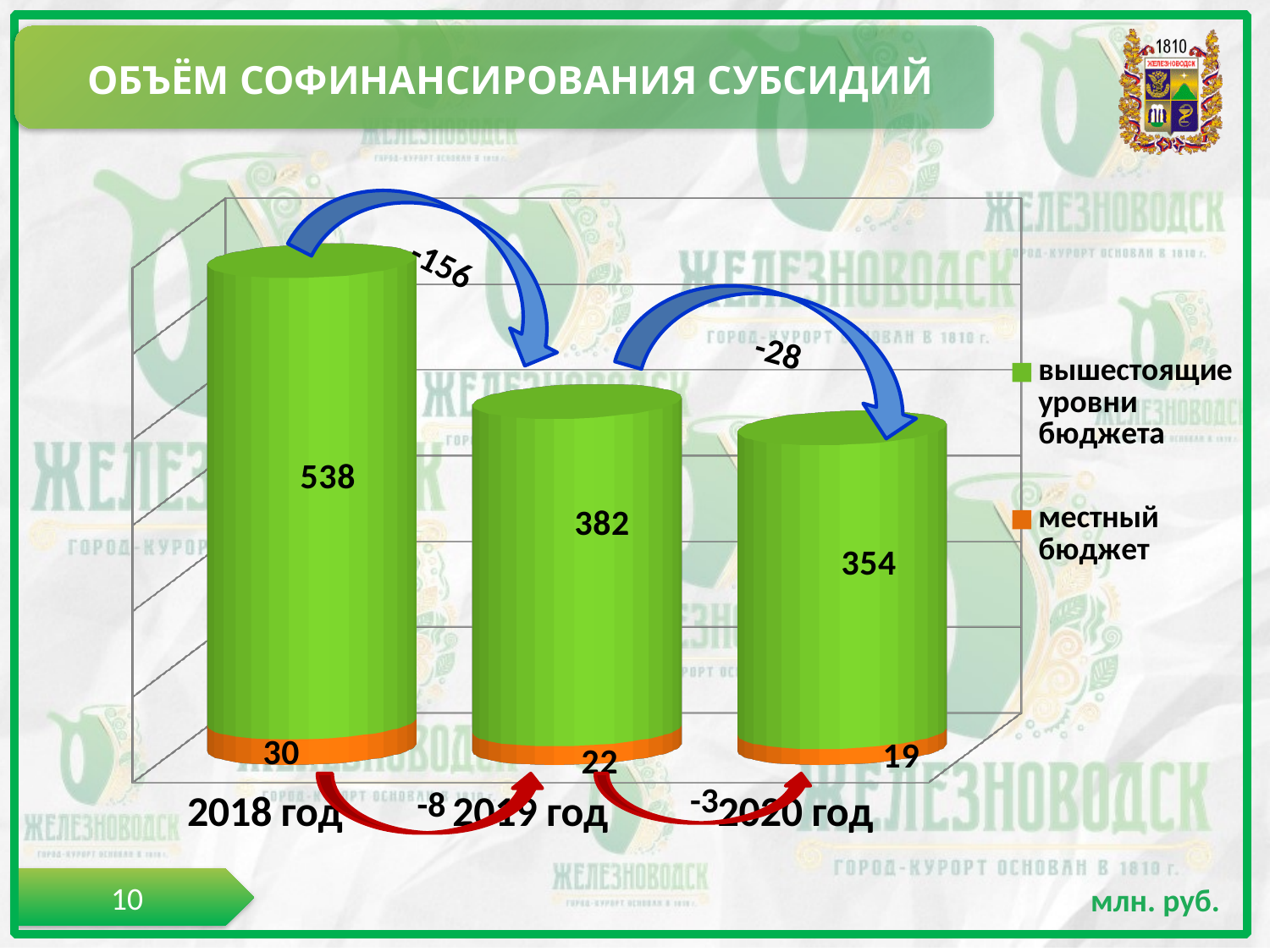
Which year has the lowest value for "местный бюджет"? 2020 год Which is larger: the "местный бюджет" value for 2018 год or for 2019 год? 2018 год Do the "вышестоящие уровни бюджета" values rise or fall from 2018 год to 2020 год? Fall Which year has the highest value for "вышестоящие уровни бюджета"? 2018 год How many series does the legend list? 2 How many years are shown on the x axis? 3 What is the value for "местный бюджет" in 2020 год? 19 What kind of chart is shown on the slide? Stacked bar chart What is the value for "вышестоящие уровни бюджета" in 2019 год? 382 What is the value for "вышестоящие уровни бюджета" in 2018 год? 538 What is the difference between the "вышестоящие уровни бюджета" values for 2018 год and 2019 год? 156 What is the total of the stacked bar for 2020 год? 373